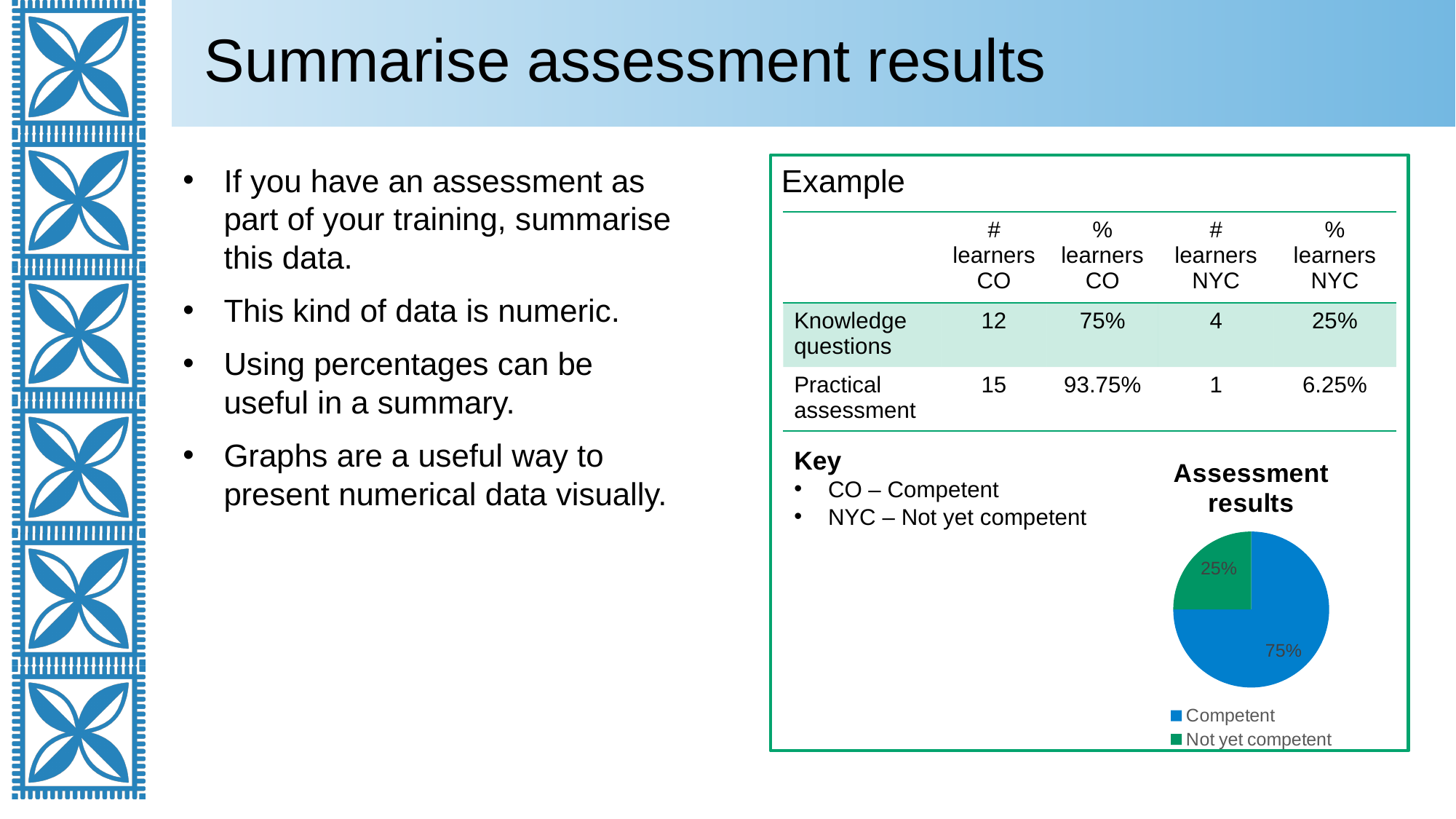
What colour is the Competent slice in the pie chart? blue What is the title of the pie chart? Assessment results Is the Competent share in the pie chart greater or less than 50%? greater What kind of chart is the "Assessment results" chart? pie chart What share of the pie chart is labelled Competent? 75% Which is larger in the pie chart, Competent or Not yet competent? Competent What is the difference in percentage points between the Competent and Not yet competent slices? 50% What share of the pie chart is labelled Not yet competent? 25% How many entries does the pie chart legend list? 2 How many slices does the pie chart have? 2 Which slice of the pie chart is the smallest? Not yet competent Which slice of the pie chart is the largest? Competent